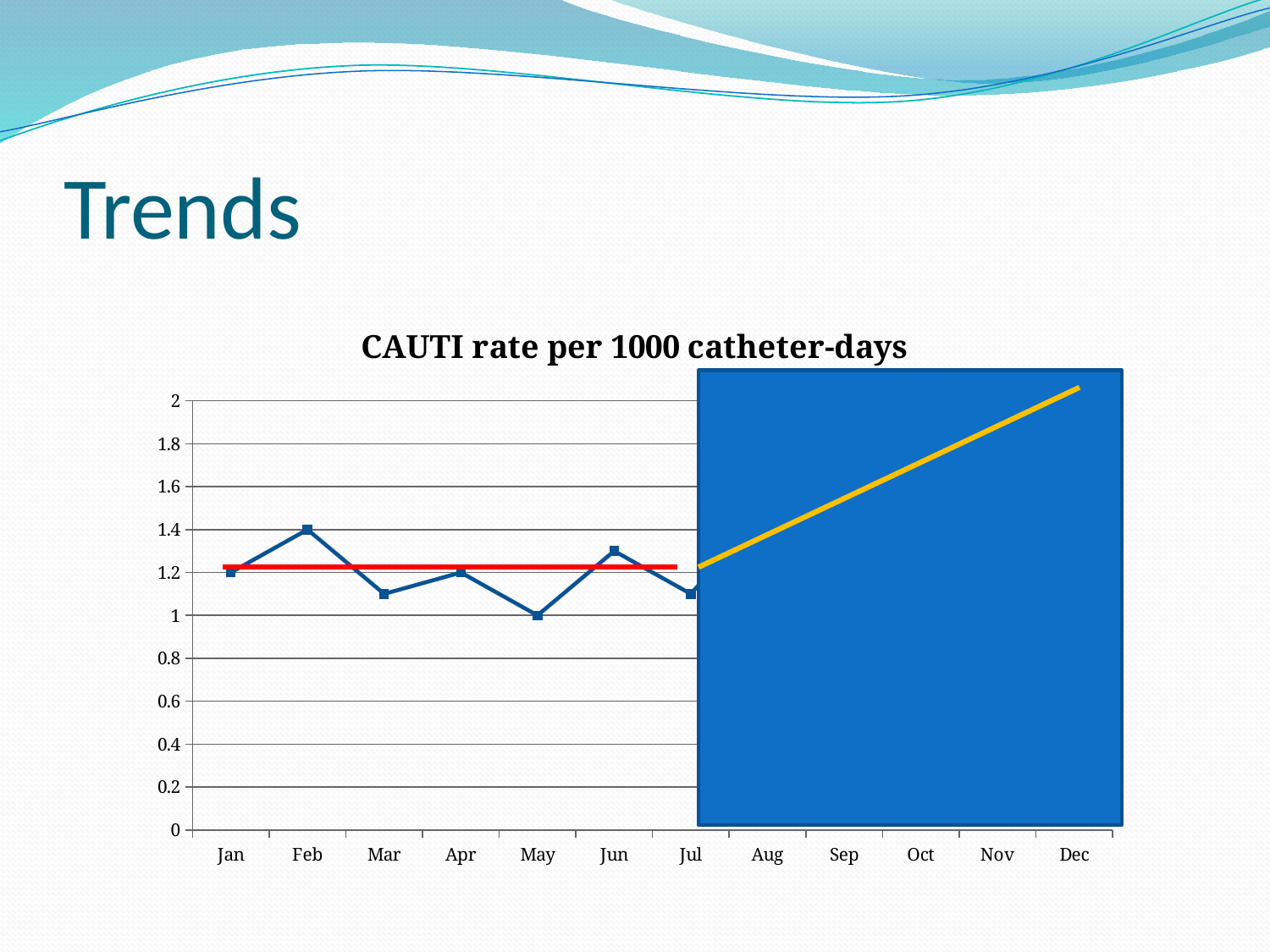
Which month from Jan to Jul has the lowest plotted CAUTI rate? May Does the yellow line in the shaded area rise or fall from Aug to Dec? rise How many months are labelled on the x axis? 12 Which month has a higher CAUTI rate, Feb or Mar? Feb What is the CAUTI rate per 1000 catheter-days for Feb? 1.4 Is the value for Jun greater or less than 1.2? greater What kind of chart is shown on the slide? line chart Is the value for Mar greater or less than 1.2? less What is the title of the chart? CAUTI rate per 1000 catheter-days Which month from Jan to Jul has the highest plotted CAUTI rate? Feb What is the difference between the CAUTI rate for Feb and for May? 0.4 What is the CAUTI rate per 1000 catheter-days for May? 1